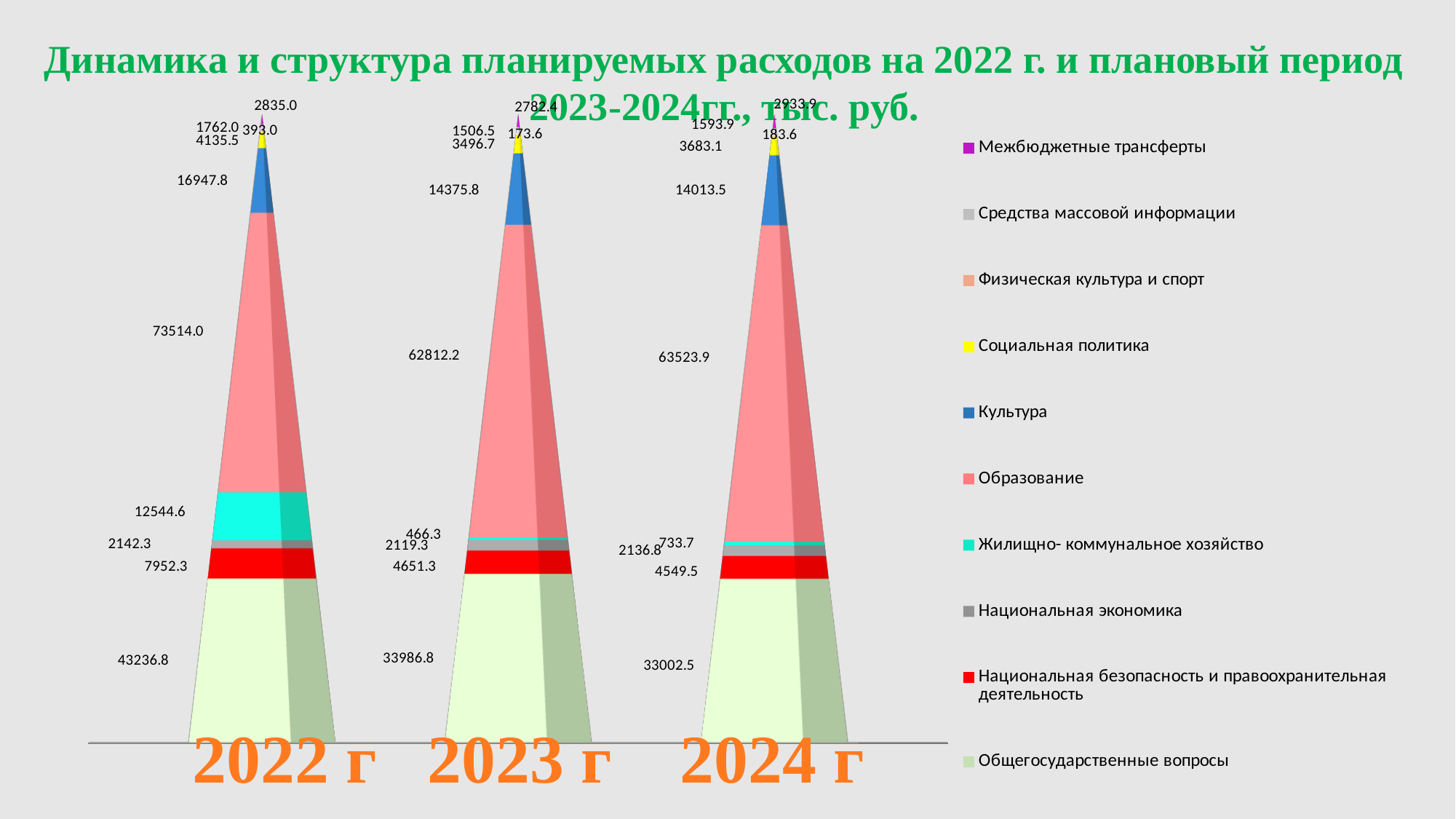
What is the value for Культура in 2023? 14375.8 Which year has the highest value for Образование? 2022 How many years are shown on the x axis? 3 What is the value for Общегосударственные вопросы in 2024? 33002.5 What is the difference between the Образование values for 2022 and 2023? 10701.8 Which is larger: Национальная безопасность и правоохранительная деятельность in 2023 or in 2024? 2023 What is the value for Межбюджетные трансферты in 2024? 2933.9 Which year has the lowest value for Средства массовой информации? 2023 What is the value for Жилищно-коммунальное хозяйство in 2023? 466.3 What is the value for Образование in 2022? 73514.0 Does the value for Общегосударственные вопросы rise or fall from 2022 to 2024? fall How many series does the legend list? 10